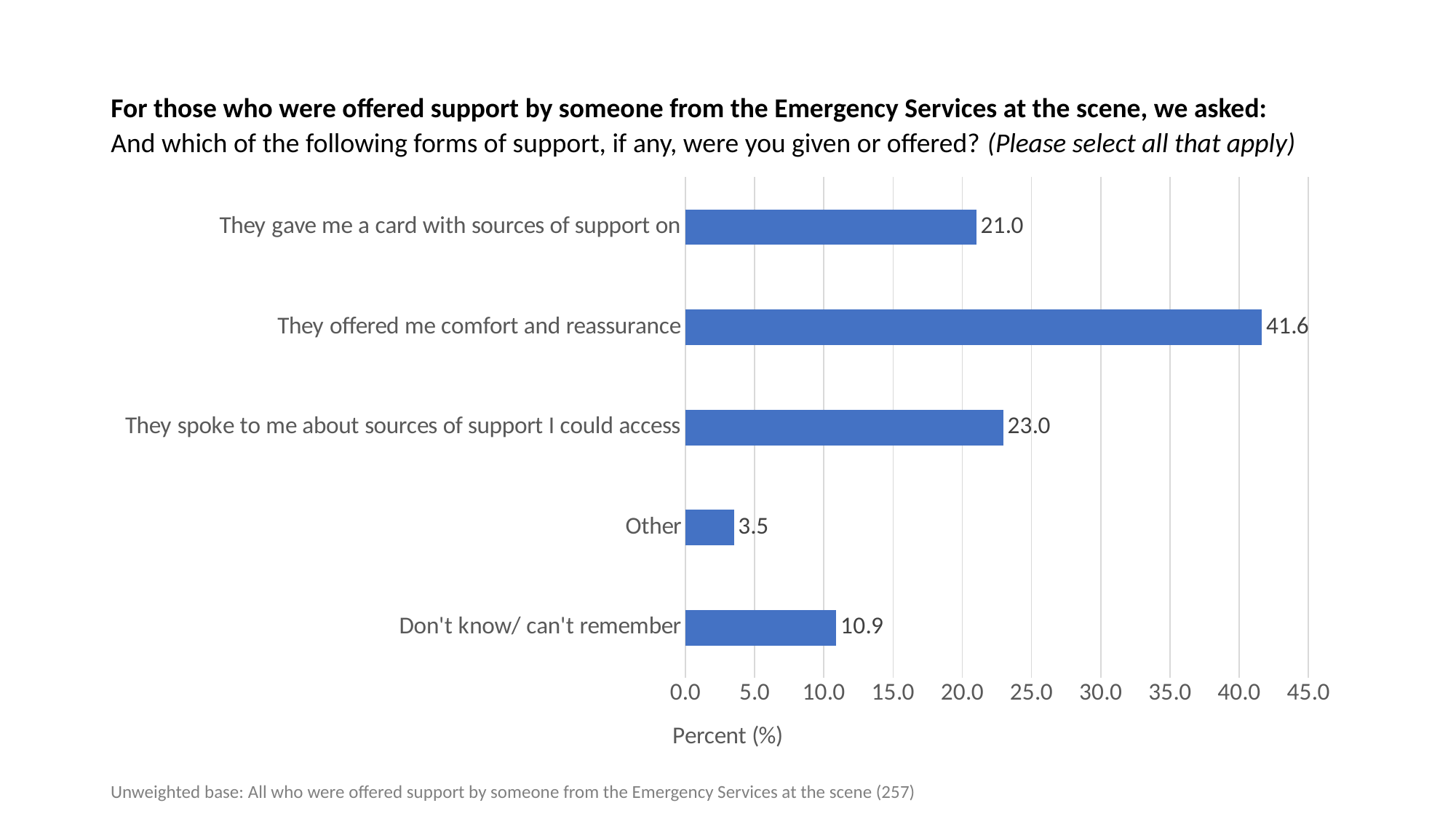
How many categories are shown in the chart? 5 What is the value for "Don't know/ can't remember"? 10.9 What is the value for "They gave me a card with sources of support on"? 21.0 Is the value for "They offered me comfort and reassurance" greater or less than 40.0? greater What is the value for "Other"? 3.5 What is the difference between "They spoke to me about sources of support I could access" and "They gave me a card with sources of support on"? 2.0 What is the value for "They offered me comfort and reassurance"? 41.6 Which is larger: the value for "They spoke to me about sources of support I could access" or the value for "Don't know/ can't remember"? They spoke to me about sources of support I could access Which category has the lowest value? Other What kind of chart is shown on the slide? bar chart What is the label of the horizontal axis? Percent (%) Which category has the highest value? They offered me comfort and reassurance